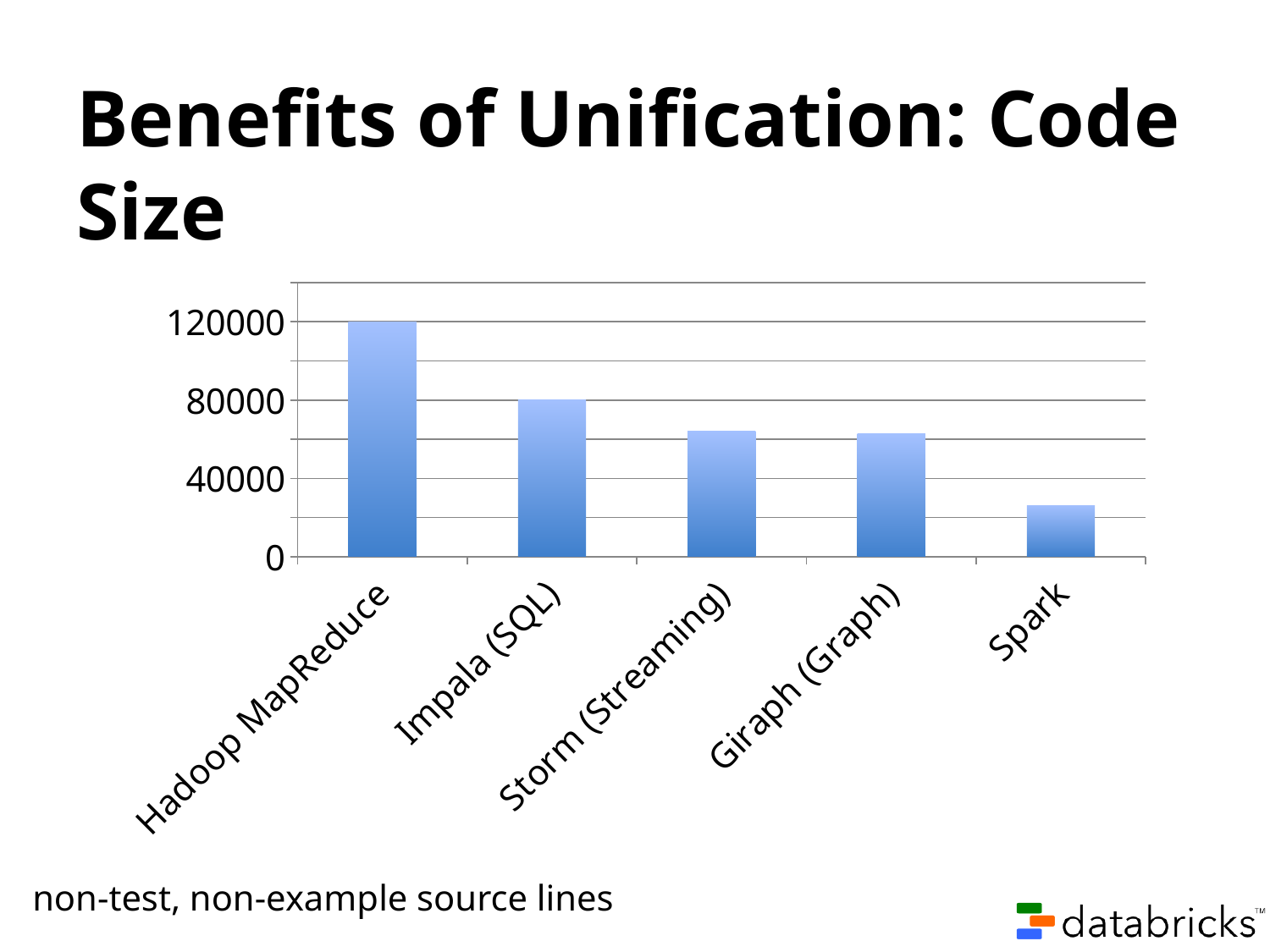
What is the difference between the values for Hadoop MapReduce and Impala (SQL)? 40000 What is the value for Hadoop MapReduce? 120000 Which system has the highest value in the chart? Hadoop MapReduce According to the note below the chart, what do the values represent? non-test, non-example source lines Which is larger, the value for Spark or the value for Giraph (Graph)? Giraph (Graph) Is the value for Spark greater or less than 40000? less Is the value for Storm (Streaming) greater or less than 40000? greater What kind of chart is shown on the slide? bar chart Is the value for Giraph (Graph) greater or less than 80000? less How many categories (systems) are plotted in the chart? 5 Which system has the lowest value in the chart? Spark What is the value for Impala (SQL)? 80000